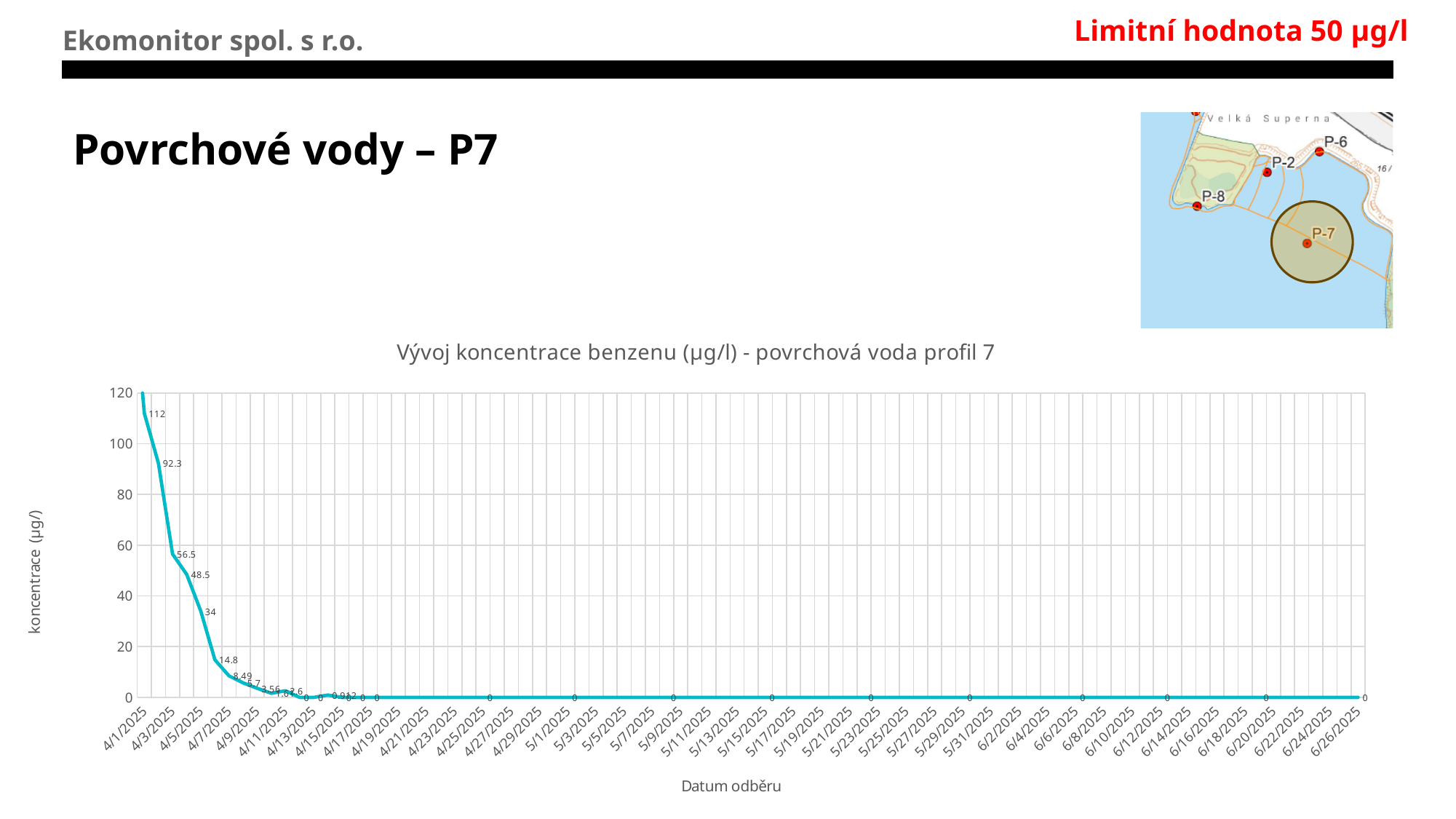
What is the value of the last data point, on 6/26/2025? 0 What is the difference between the data labels 112 and 92.3? 19.7 What kind of chart is shown on the slide? line chart Is the value on 5/1/2025 greater or less than 20? less What is the label of the vertical axis of the chart? koncentrace (µg/l) What is the title of the chart? Vývoj koncentrace benzenu (µg/l) - povrchová voda profil 7 Which is larger, the data label 56.5 or the data label 34? 56.5 Do the benzene concentration values rise or fall along the x axis over the period shown? fall How many printed data labels on the chart exceed the limit value of 50 µg/l? 3 Is the value on 4/1/2025 greater or less than 100? greater What is the difference between the data labels 56.5 and 48.5? 8 What is the highest data label printed on the chart? 112